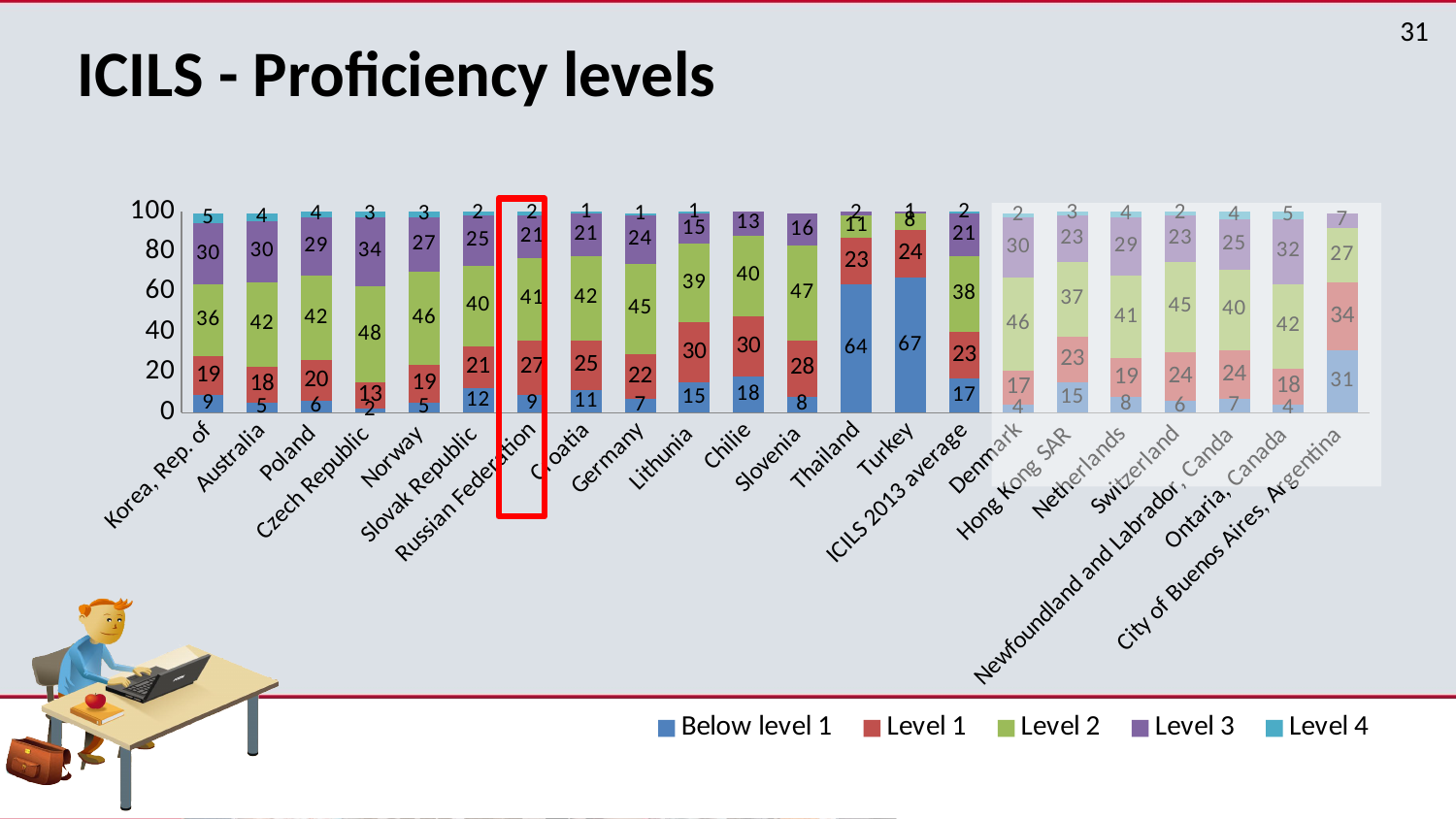
What is the Level 2 value for the ICILS 2013 average? 38 What is the Level 3 value for Ontario, Canada? 32 Which has the larger Level 1 value, Russian Federation or Croatia? Russian Federation What kind of chart is shown on the slide? Stacked bar chart Which category is highlighted with a red box on the chart? Russian Federation Which category has the highest Below level 1 value? Turkey What is the Level 2 value for the Czech Republic? 48 Which category has the lowest Level 2 value? Turkey What is the difference between the Level 2 values for Slovenia and Chile? 7 How many series does the legend list? 5 What is the Level 4 value for Korea, Rep. of? 5 What is the Below level 1 value for Turkey? 67